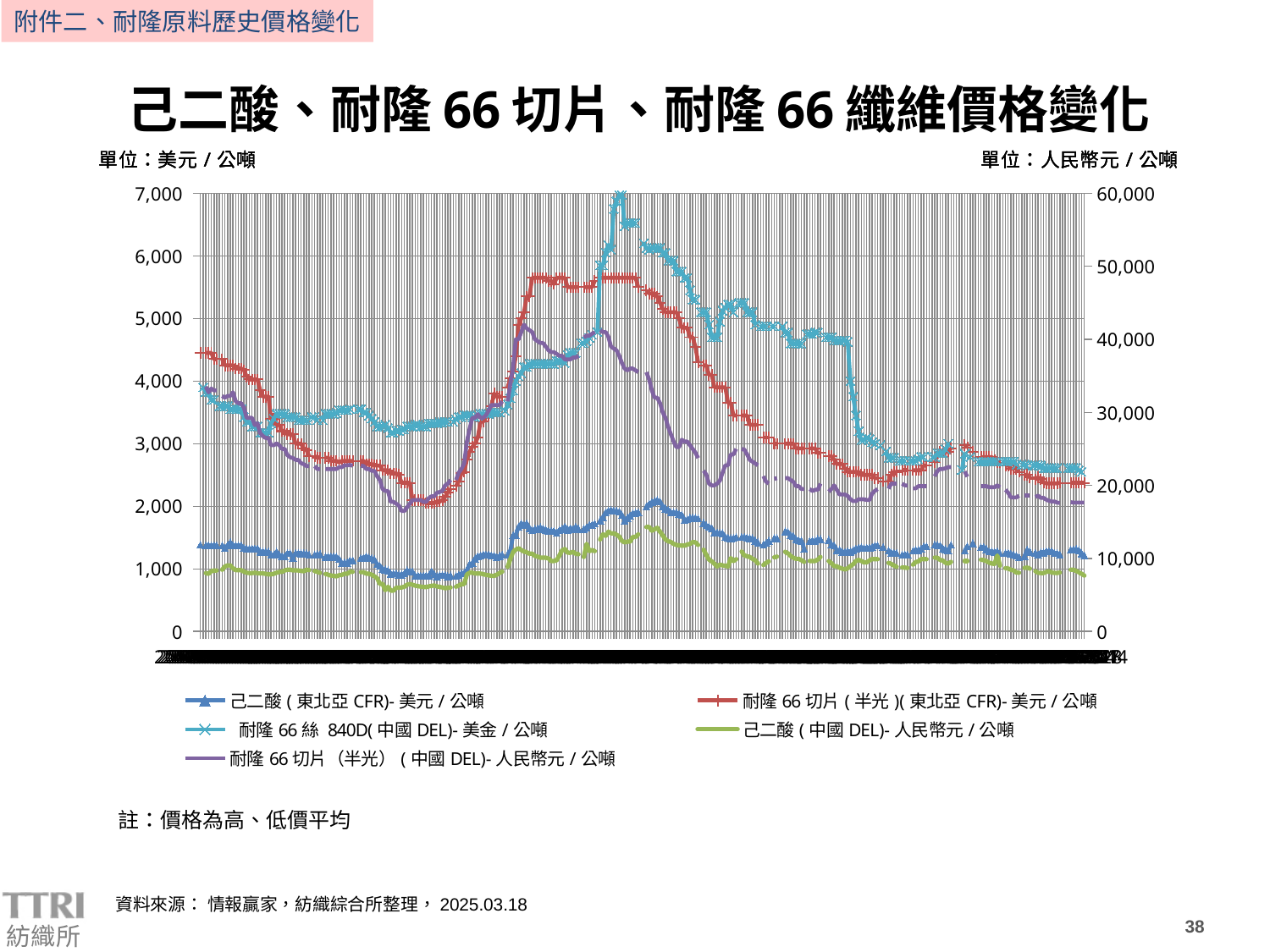
Is the peak value of the 耐隆66絲 840D(中國DEL) series greater or less than 6,000? greater Which series has the higher peak: 耐隆66絲 840D(中國DEL) or 耐隆66切片(半光)(東北亞CFR)? 耐隆66絲 840D(中國DEL) Is the peak value of the 己二酸(中國DEL)-人民幣元/公噸 series greater or less than 20,000 on the right axis? less Which series reaches the highest value on the left (美元/公噸) axis? 耐隆66絲 840D(中國DEL)-美金/公噸 What unit is shown for the right-hand axis of the chart? 人民幣元/公噸 What is the title of the chart? 己二酸、耐隆66切片、耐隆66纖維價格變化 Is the peak value of the 己二酸(東北亞CFR) series greater or less than 3,000? less How many series does the chart legend list? 5 Comparing the start and the end of the x axis, does the 耐隆66切片(半光)(東北亞CFR) series rise or fall overall? fall What kind of chart is shown on the slide? line chart